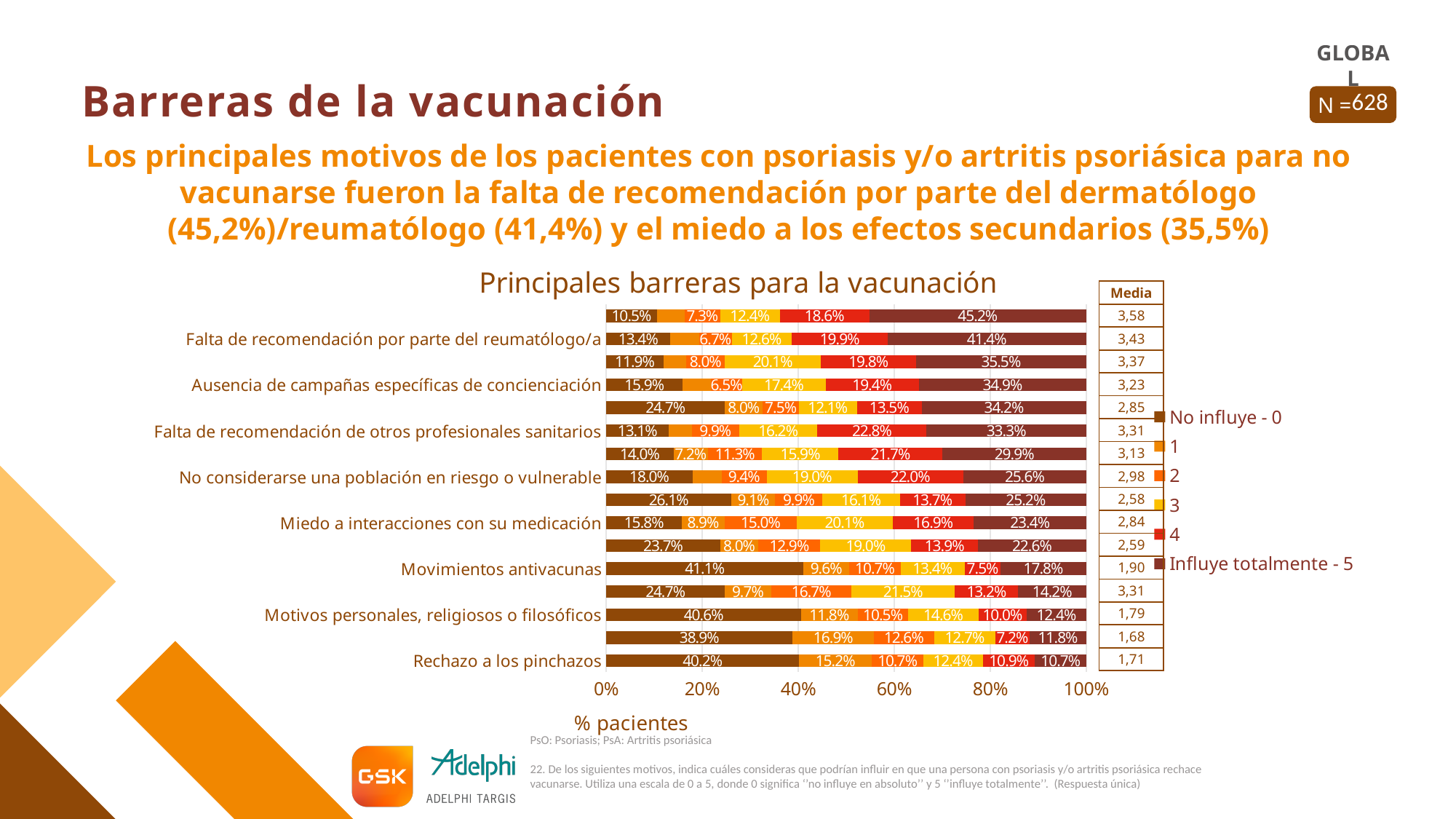
What percentage of patients answered 'No influye - 0' for 'Movimientos antivacunas'? 41.1% What is the title of the x axis of the chart? % pacientes What is the 'Media' value shown for 'Movimientos antivacunas'? 1,90 What is the 'Media' value shown for 'Rechazo a los pinchazos'? 1,71 What kind of chart is 'Principales barreras para la vacunación'? Stacked bar chart Which has a higher 'Media' value: 'Falta de recomendación por parte del reumatólogo/a' or 'Falta de recomendación de otros profesionales sanitarios'? Falta de recomendación por parte del reumatólogo/a What percentage of patients answered 'Influye totalmente - 5' for 'Falta de recomendación por parte del reumatólogo/a'? 41.4% What percentage of patients answered 'Influye totalmente - 5' for 'Rechazo a los pinchazos'? 10.7% What is the difference in the 'No influye - 0' share between 'Movimientos antivacunas' and 'Rechazo a los pinchazos'? 0.9 percentage points How many series does the legend of the chart list? 6 What percentage of patients answered 'Influye totalmente - 5' for 'Ausencia de campañas específicas de concienciación'? 34.9% Which has a larger 'Influye totalmente - 5' share: 'Miedo a interacciones con su medicación' or 'Movimientos antivacunas'? Miedo a interacciones con su medicación